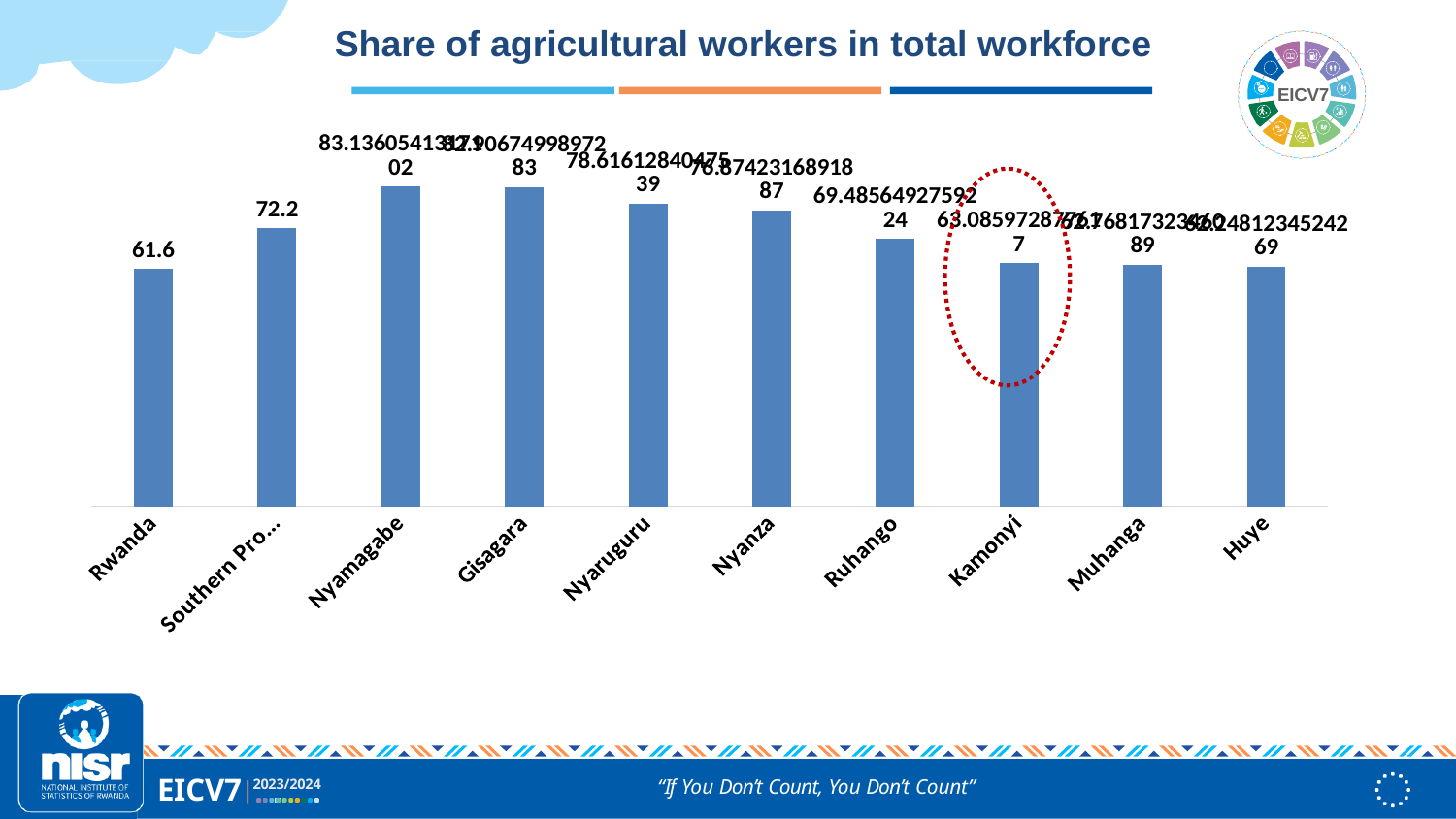
What is the difference between the values for Southern Pro... and Rwanda? 10.6 What is the value shown for Southern Pro...? 72.2 Which has the larger value, Nyamagabe or Rwanda? Nyamagabe Which category's bar is highlighted with a red dotted circle? Kamonyi What kind of chart is shown on the slide? bar chart How many bars (categories) are plotted in the chart? 10 Which has the larger value, Nyanza or Kamonyi? Nyanza What is the title of the chart? Share of agricultural workers in total workforce Which has the larger value, Rwanda or Southern Pro...? Southern Pro... Which is the first category on the x axis? Rwanda What is the value shown for Rwanda? 61.6